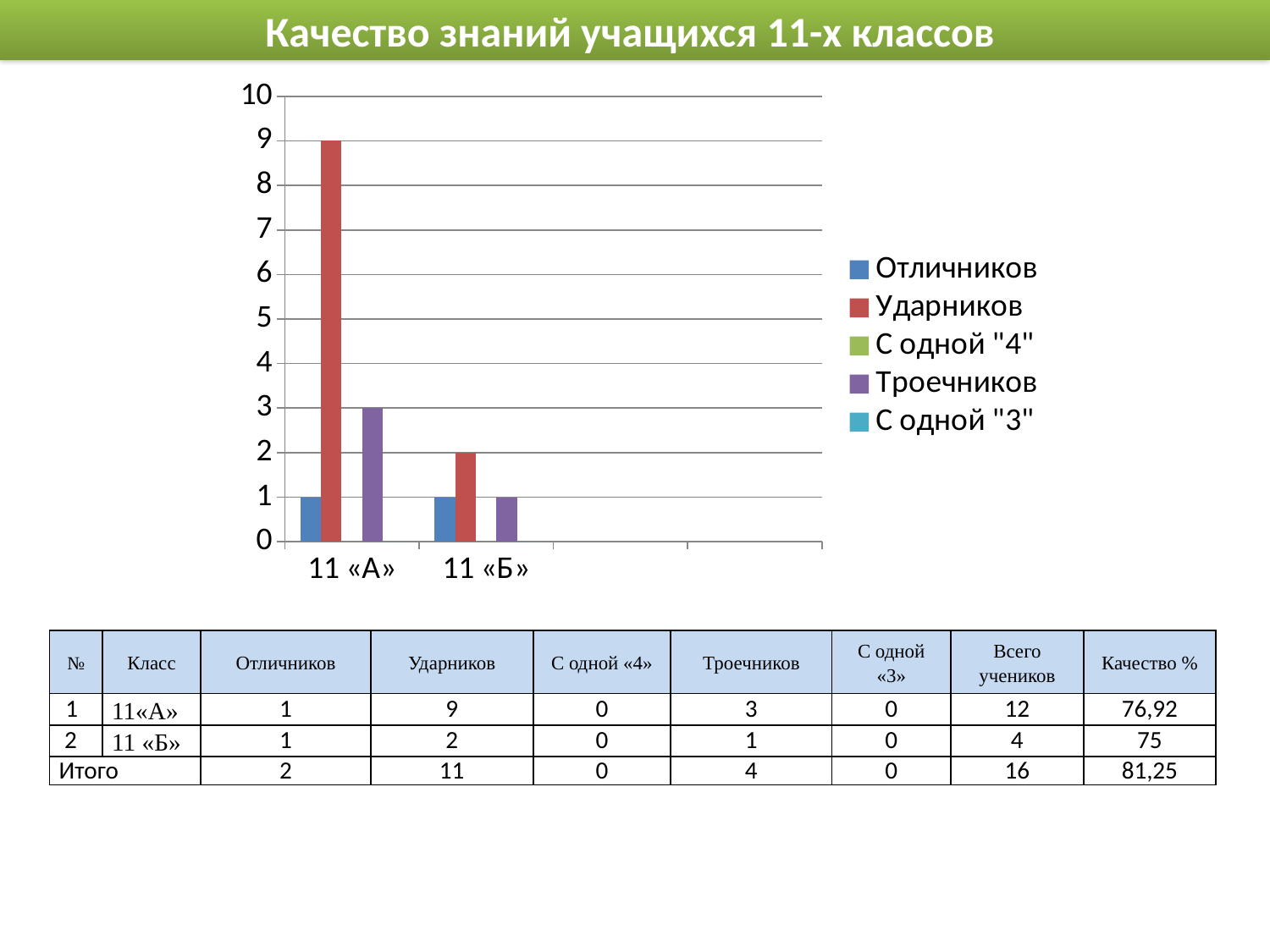
What is the value of Троечников for 11 «А»? 3 Is the value of Ударников for 11 «А» greater or less than 5? greater What is the value of Отличников for 11 «Б»? 1 How many series does the chart legend list? 5 How many class categories are shown on the x axis of the chart? 2 What kind of chart is shown on the slide? bar chart Which series has the highest value for 11 «А»? Ударников What is the value of Ударников for 11 «А»? 9 What is the value of Ударников for 11 «Б»? 2 What is the difference between Ударников for 11 «А» and Ударников for 11 «Б»? 7 Which is larger: Троечников for 11 «А» or Троечников for 11 «Б»? 11 «А» What is the maximum value shown on the chart's vertical axis? 10